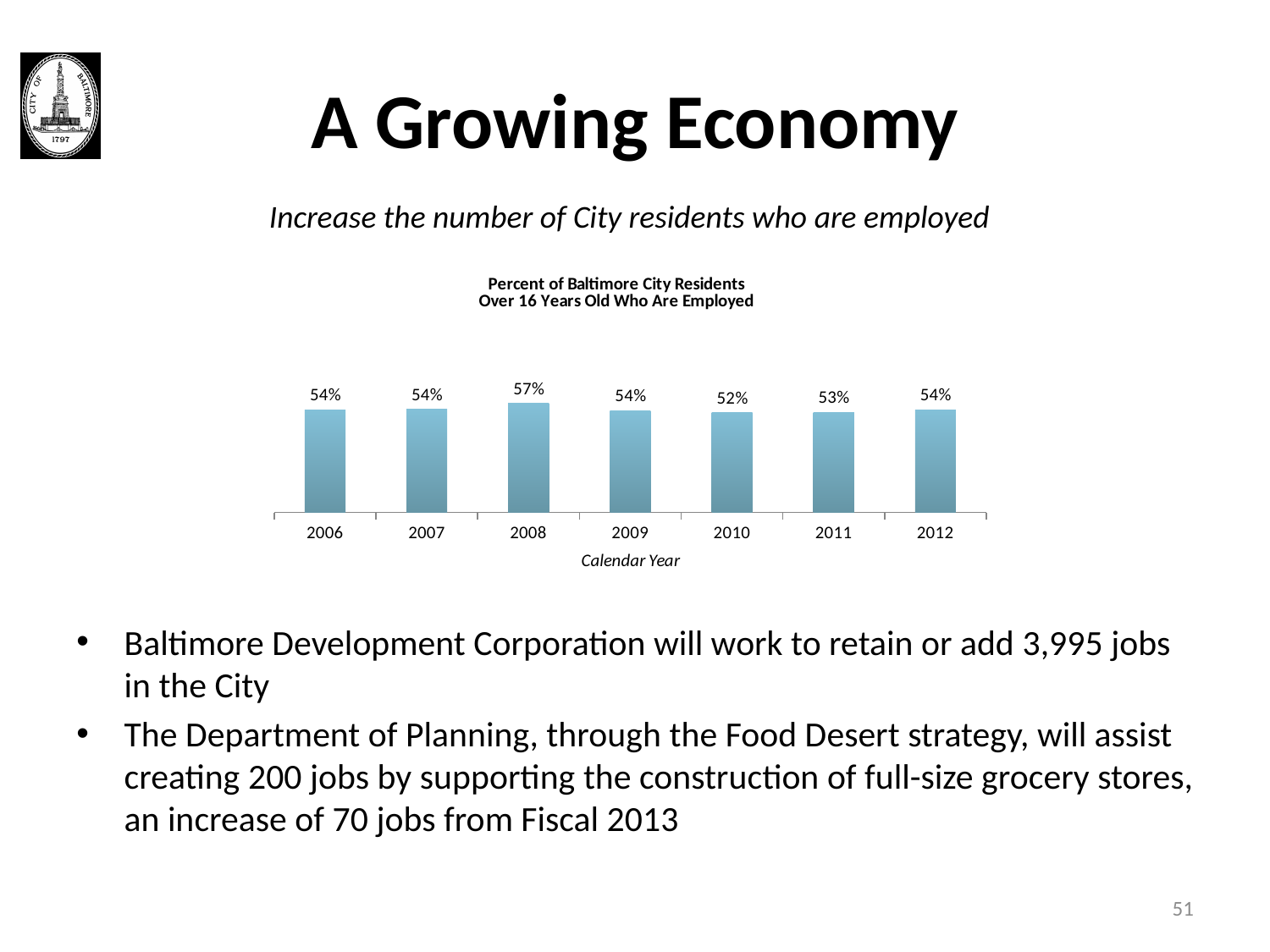
Which calendar year has the highest percent of residents employed? 2008 What is the difference between the values for 2009 and 2011? 1% What is the value shown for 2010? 52% What is the label of the x axis of the chart? Calendar Year Which is larger, the value for 2008 or the value for 2012? 2008 How many calendar years are shown in the chart? 7 What is the difference between the values for 2008 and 2010? 5% What is the percent of Baltimore City residents over 16 years old who are employed in 2008? 57% Which calendar year has the lowest percent of residents employed? 2010 What is the value shown for 2011? 53% What kind of chart is shown on the slide? Bar chart What is the value shown for 2006? 54%